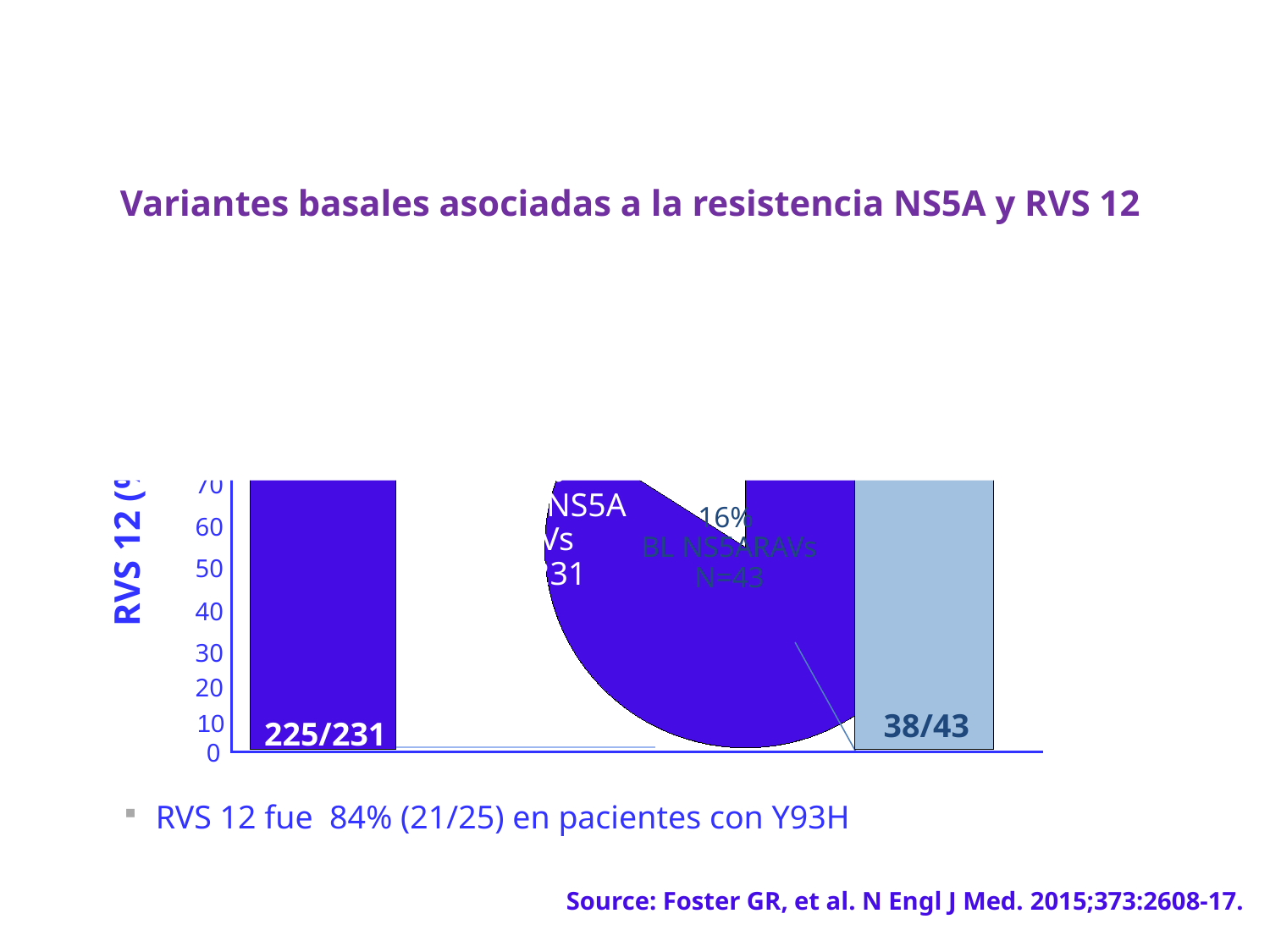
In the bar chart, is the value of the right bar greater or less than 50? greater What kind of chart is the chart overlapping the bars in the middle of the slide, showing 16%? pie chart In the bar chart, what fraction is printed on the left bar? 225/231 In the pie chart, what percentage is shown for the BL NS5A RAVs slice? 16% In the bar chart, what colour is the right bar? light blue In the pie chart, what N is given for the BL NS5A RAVs slice? N=43 In the bar chart, how many bars are plotted? 2 What kind of chart is the chart on the left of the slide with the RVS 12 (%) axis? bar chart What is the label of the vertical axis of the bar chart? RVS 12 (%) In the bar chart, is the value of the left bar greater or less than 60? greater In the bar chart, what fraction is printed on the right bar? 38/43